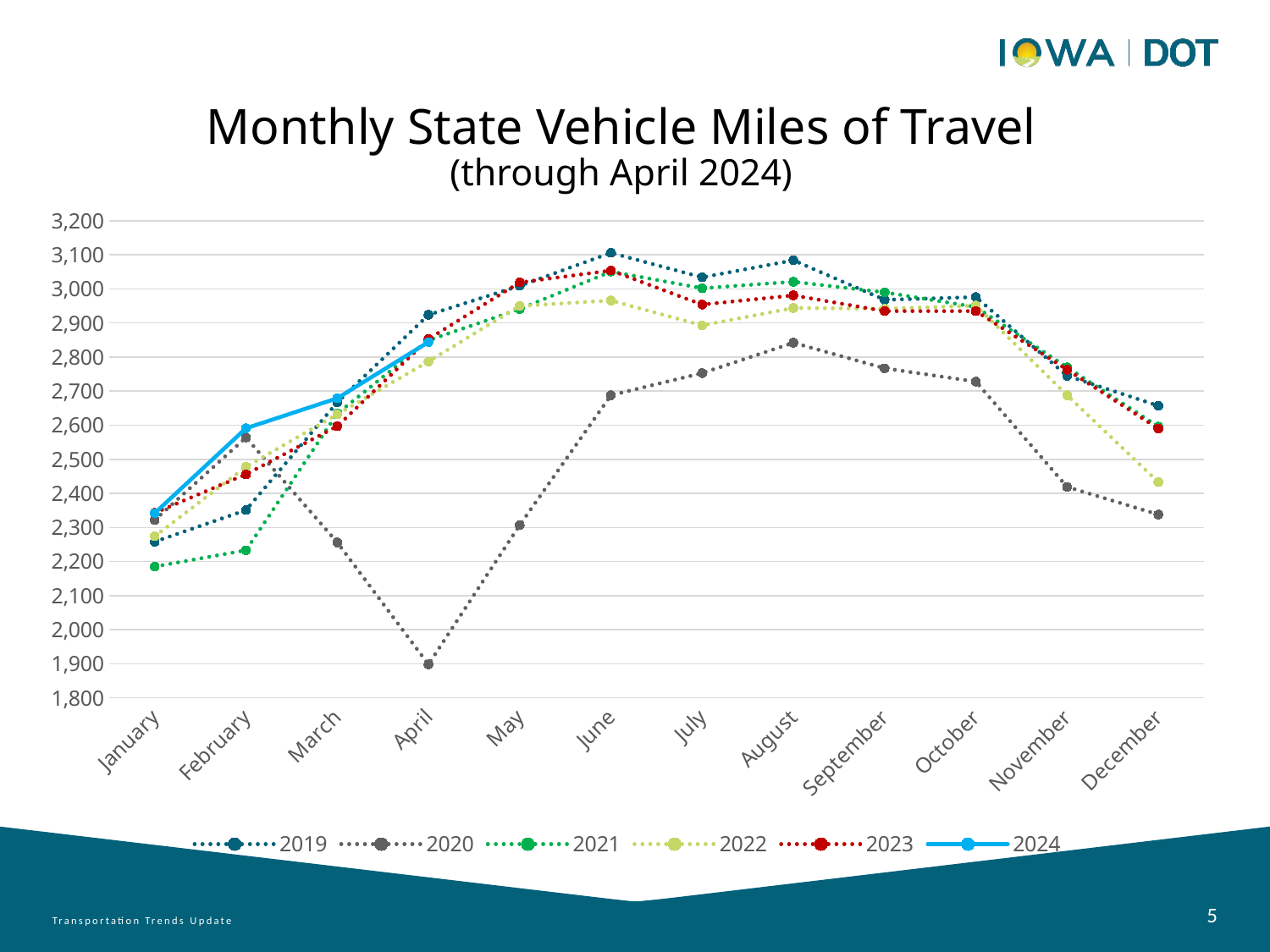
Which series has the larger value in August, 2019 or 2020? 2019 How many series does the legend list? 6 Is the value for 2020 in December greater or less than 2,400? less In which month does the 2019 series reach its highest value? June In which month does the 2020 series reach its lowest value? April Does the 2024 series rise or fall from January to April? Rise What is the title of the chart? Monthly State Vehicle Miles of Travel (through April 2024) What type of chart is shown on the slide? Line chart How many months are shown along the x axis? 12 Is the value for 2020 in April greater or less than 2,000? less Is the value for 2024 in April greater or less than 2,800? greater How many data points does the 2024 series have? 4